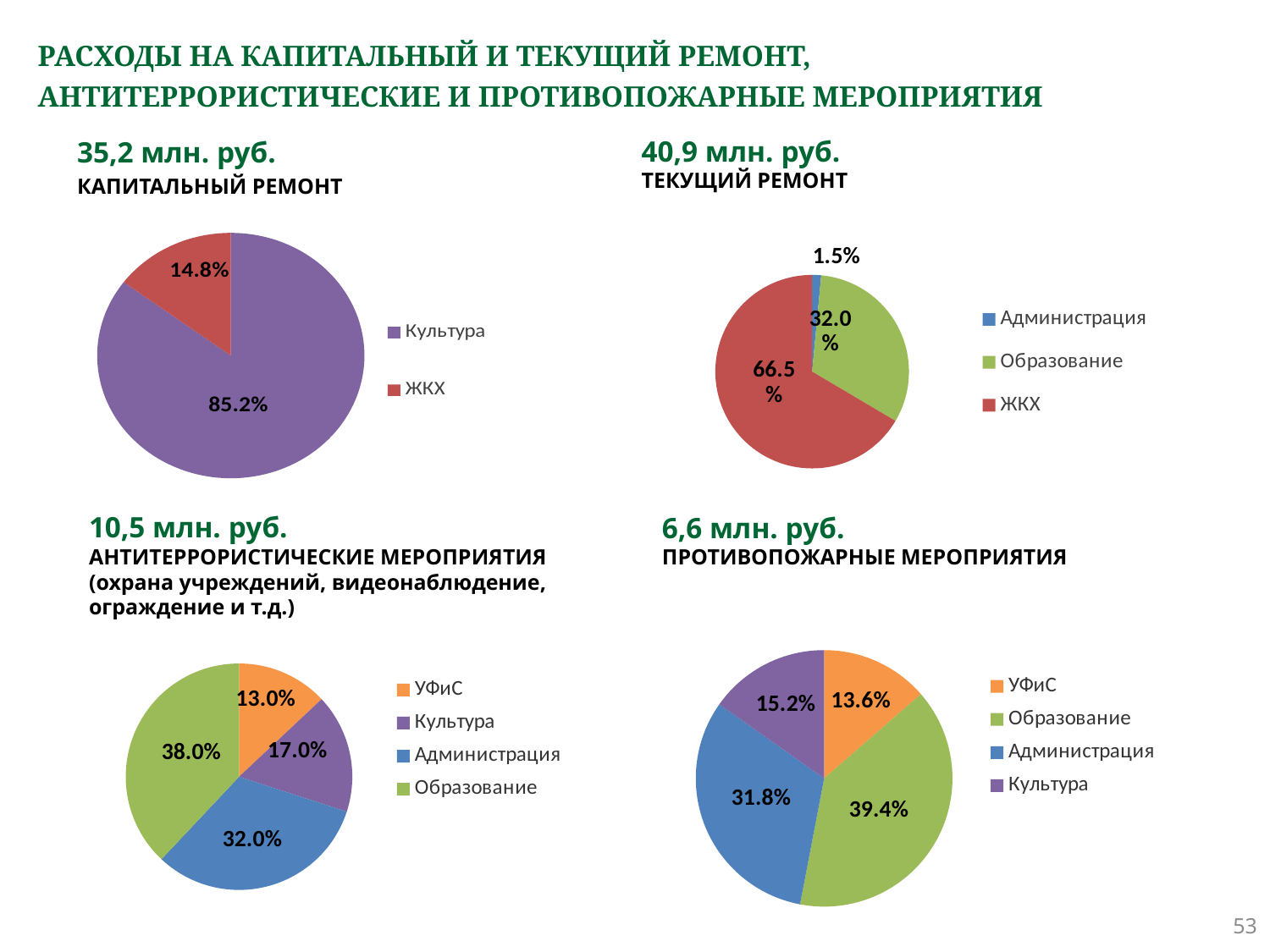
In the ТЕКУЩИЙ РЕМОНТ pie chart, how many categories does the legend list? 3 In the АНТИТЕРРОРИСТИЧЕСКИЕ МЕРОПРИЯТИЯ pie chart, what share does Образование have? 38.0% What type of chart is used for ТЕКУЩИЙ РЕМОНТ? Pie chart In the ПРОТИВОПОЖАРНЫЕ МЕРОПРИЯТИЯ pie chart, which is larger: the share of Культура or the share of УФиС? Культура In the КАПИТАЛЬНЫЙ РЕМОНТ pie chart, what share does Культура have? 85.2% In the ТЕКУЩИЙ РЕМОНТ pie chart, what share does Администрация have? 1.5% In the ПРОТИВОПОЖАРНЫЕ МЕРОПРИЯТИЯ pie chart, how many categories are shown? 4 In the ТЕКУЩИЙ РЕМОНТ pie chart, which category has the largest share? ЖКХ In the АНТИТЕРРОРИСТИЧЕСКИЕ МЕРОПРИЯТИЯ pie chart, what is the difference between the shares of Администрация and Культура? 15.0% In the АНТИТЕРРОРИСТИЧЕСКИЕ МЕРОПРИЯТИЯ pie chart, which category has the smallest share? УФиС